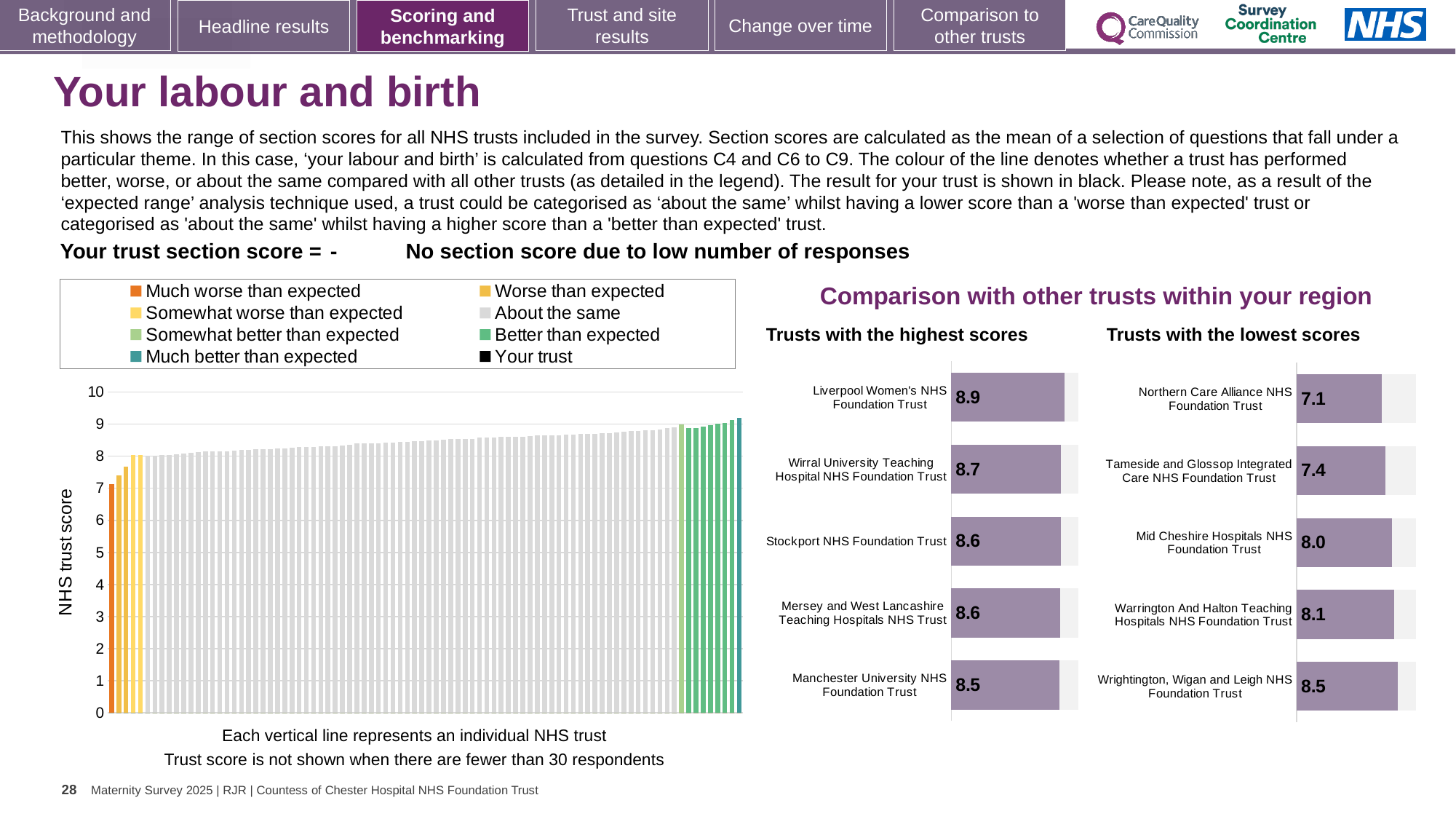
In the 'Trusts with the highest scores' chart, what is the score for Liverpool Women's NHS Foundation Trust? 8.9 How many entries does the legend of the NHS trust score chart on the left list? 8 In the 'Trusts with the highest scores' chart, which trust has the highest score? Liverpool Women's NHS Foundation Trust In the 'Trusts with the lowest scores' chart, how much higher is Tameside and Glossop Integrated Care NHS Foundation Trust's score than Northern Care Alliance NHS Foundation Trust's? 0.3 What kind of chart is the NHS trust score chart on the left of the slide? Bar chart In the 'Trusts with the highest scores' chart, what is the difference between the scores of Liverpool Women's NHS Foundation Trust and Manchester University NHS Foundation Trust? 0.4 In the 'Trusts with the lowest scores' chart, which trust has the lowest score? Northern Care Alliance NHS Foundation Trust In the 'Trusts with the lowest scores' chart, what is the score for Mid Cheshire Hospitals NHS Foundation Trust? 8.0 In the 'Trusts with the lowest scores' chart, what is the score for Northern Care Alliance NHS Foundation Trust? 7.1 In the 'Trusts with the highest scores' chart, which has the larger score: Wirral University Teaching Hospital NHS Foundation Trust or Stockport NHS Foundation Trust? Wirral University Teaching Hospital NHS Foundation Trust In the NHS trust score chart on the left, is the value of the rightmost bar greater or less than 9? greater How many trusts are listed in the 'Trusts with the highest scores' chart? 5